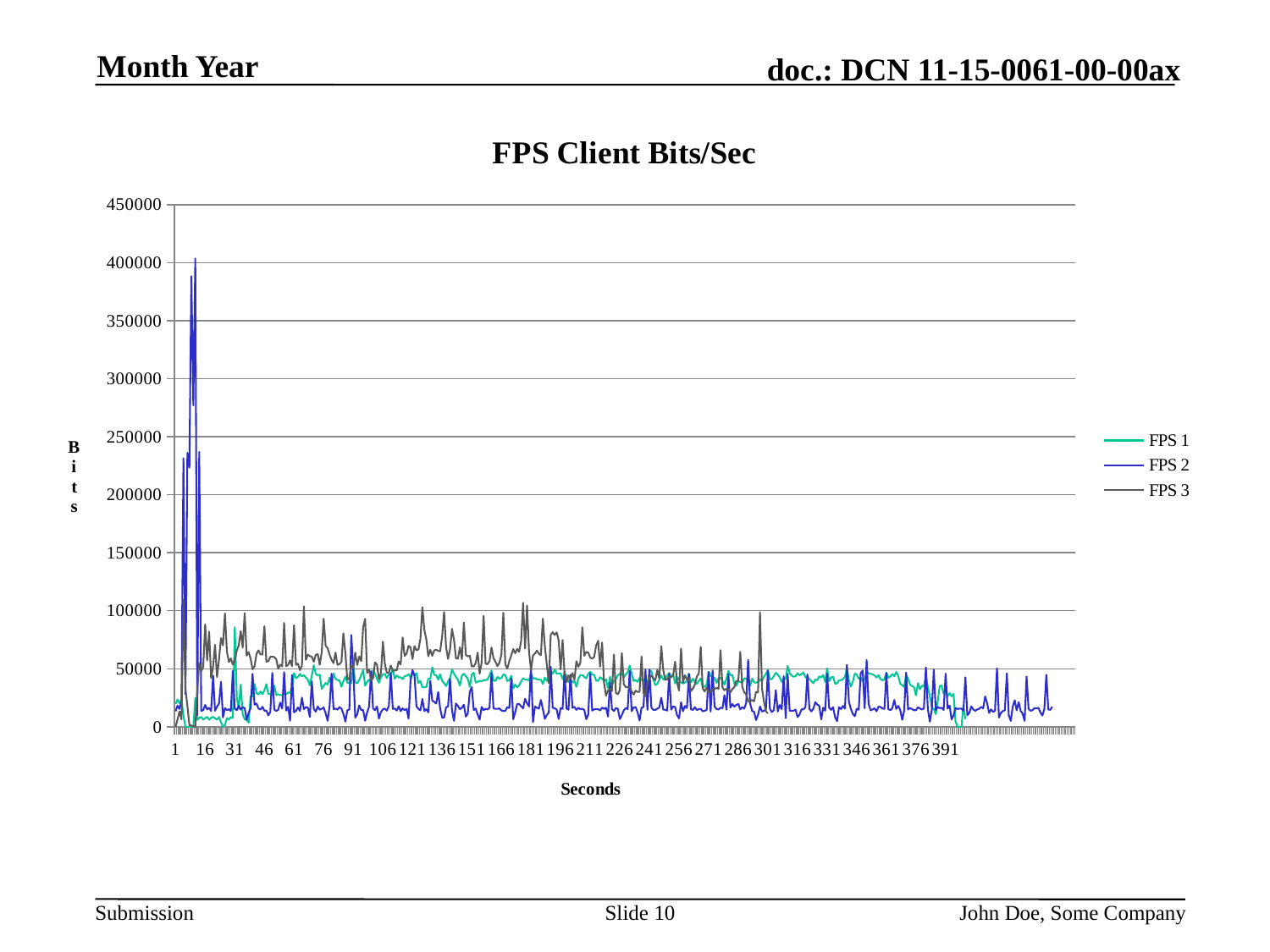
Which series has the higher peak value, FPS 2 or FPS 3? FPS 2 How many series does the legend list? 3 What is the label of the x axis? Seconds Is the highest peak of the FPS 3 series greater or less than 150000? less Is the highest peak of the FPS 2 series greater or less than 350000? greater Do the FPS 3 values generally rise or fall as the seconds increase along the x axis? fall Which series reaches the highest peak value on the chart? FPS 2 What is the title of the chart? FPS Client Bits/Sec What kind of chart is shown on the slide? line chart Is the highest peak of the FPS 1 series greater or less than 150000? less What is the highest value shown on the y axis? 450000